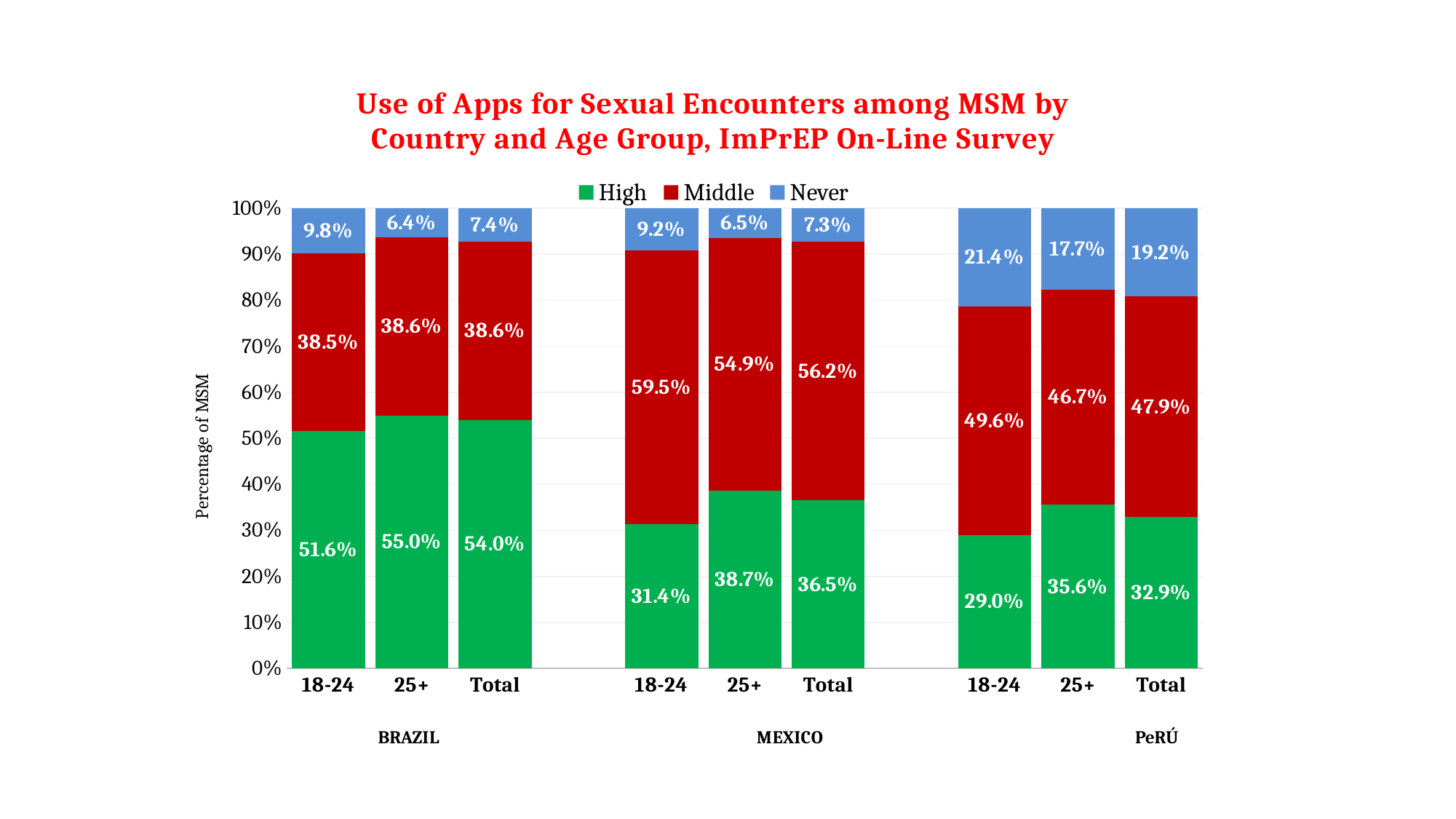
What is the Never value for the 18-24 age group in Perú? 21.4% Which bar has the highest High value across all countries and age groups? Brazil 25+ (55.0%) Which has a larger High value: the Total bar for Brazil or the Total bar for Mexico? Brazil (54.0%) What is the Middle value for the 25+ age group in Mexico? 54.9% Which country's Total bar has the highest Never share? Perú (19.2%) How many bars are plotted in the chart? 9 Which bar has the lowest High value? Perú 18-24 (29.0%) What is the difference in the Never value between the 18-24 group in Perú and the 18-24 group in Brazil? 11.6 percentage points What is the difference in the Middle value between the 18-24 group in Mexico and the 18-24 group in Brazil? 21.0 percentage points How many series does the legend list? 3 What kind of chart is shown on the slide? Stacked bar chart What percentage of MSM aged 18-24 in Brazil reported High use of apps? 51.6%